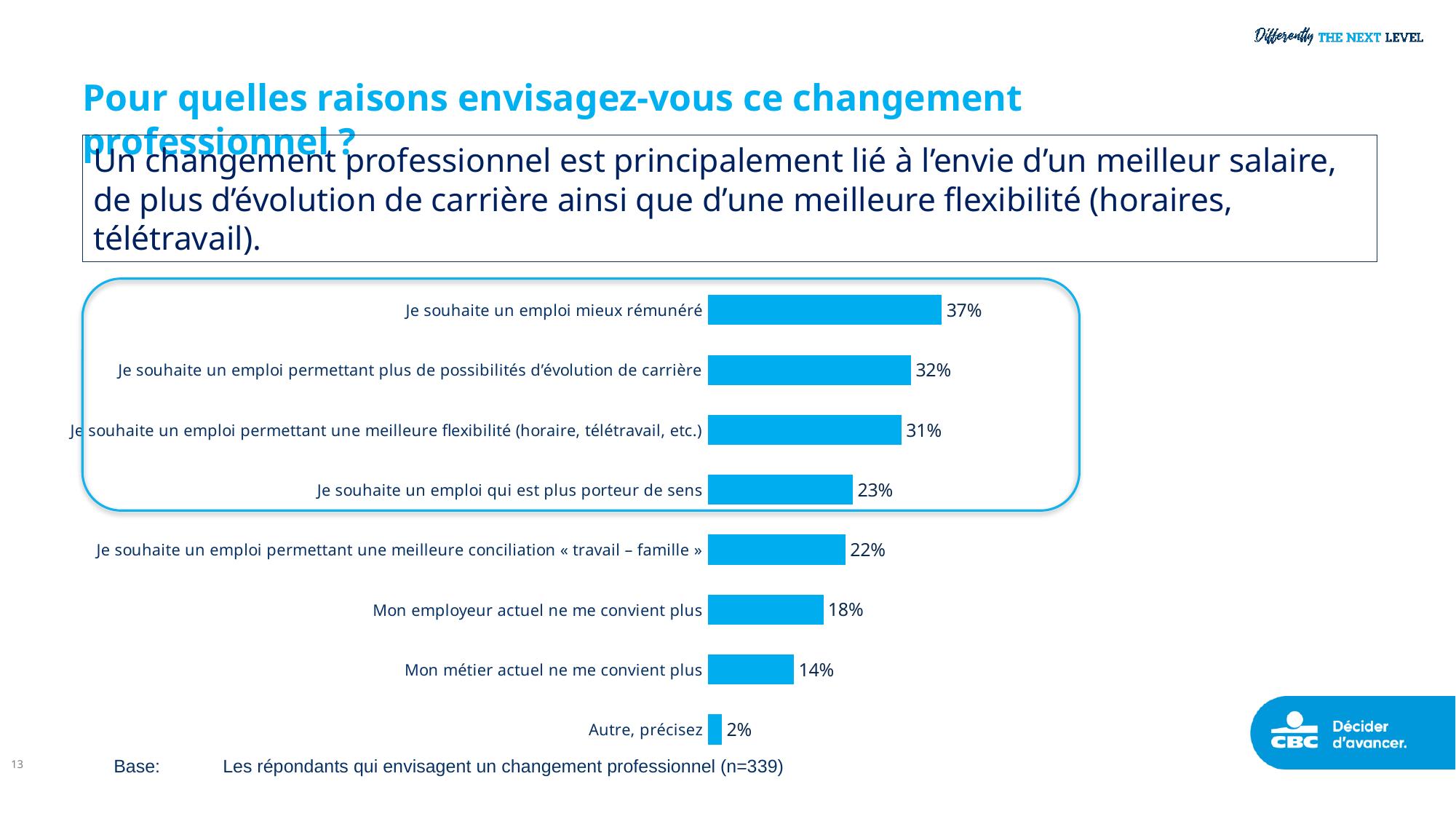
What is the value for "Je souhaite un emploi qui est plus porteur de sens"? 23% Which is larger: "Je souhaite un emploi qui est plus porteur de sens" or "Mon métier actuel ne me convient plus"? Je souhaite un emploi qui est plus porteur de sens What percentage is shown for "Mon employeur actuel ne me convient plus"? 18% What kind of chart is shown on the slide? Bar chart Which reason has the highest percentage? Je souhaite un emploi mieux rémunéré What percentage of respondents chose "Je souhaite un emploi mieux rémunéré"? 37% How many of the bars are enclosed in the rounded highlight box? 4 What is the value for "Autre, précisez"? 2% How many reasons (categories) are shown in the chart? 8 What is the difference between "Mon employeur actuel ne me convient plus" and "Mon métier actuel ne me convient plus"? 4 percentage points What is the difference between "Je souhaite un emploi mieux rémunéré" and "Je souhaite un emploi permettant plus de possibilités d'évolution de carrière"? 5 percentage points Which reason has the lowest percentage? Autre, précisez